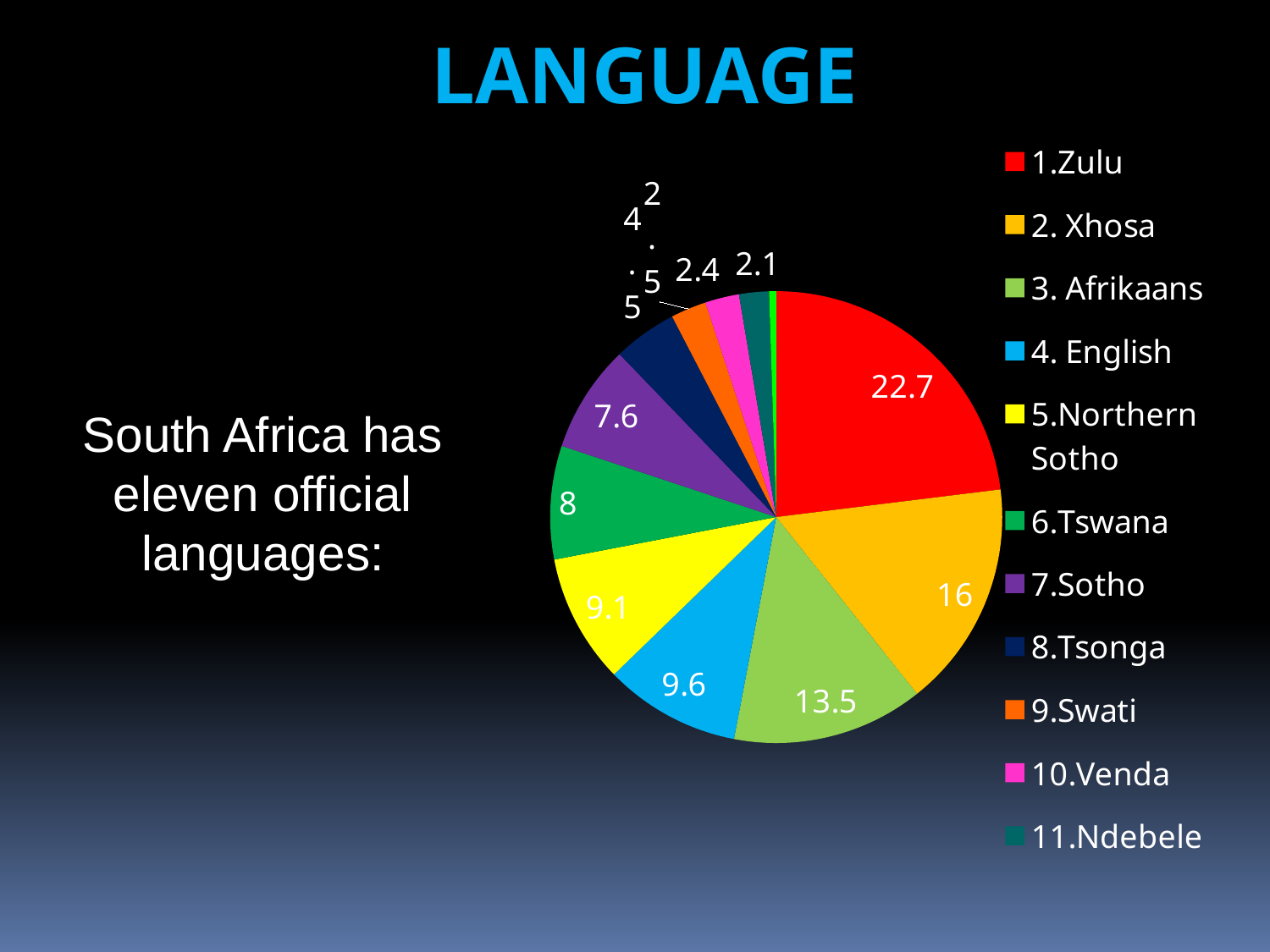
How many entries does the legend of the pie chart list? 11 What value is shown for 7.Sotho in the pie chart? 7.6 What value is shown for 1.Zulu in the pie chart? 22.7 What value is shown for 6.Tswana in the pie chart? 8 Which has the larger value, 4. English or 5.Northern Sotho? 4. English What value is shown for 5.Northern Sotho in the pie chart? 9.1 Which language has the largest slice in the pie chart? 1.Zulu What value is shown for 2. Xhosa in the pie chart? 16 What type of chart is shown on the slide? pie chart What value is shown for 3. Afrikaans in the pie chart? 13.5 What is the difference between the values for 1.Zulu and 2. Xhosa? 6.7 What value is shown for 4. English in the pie chart? 9.6